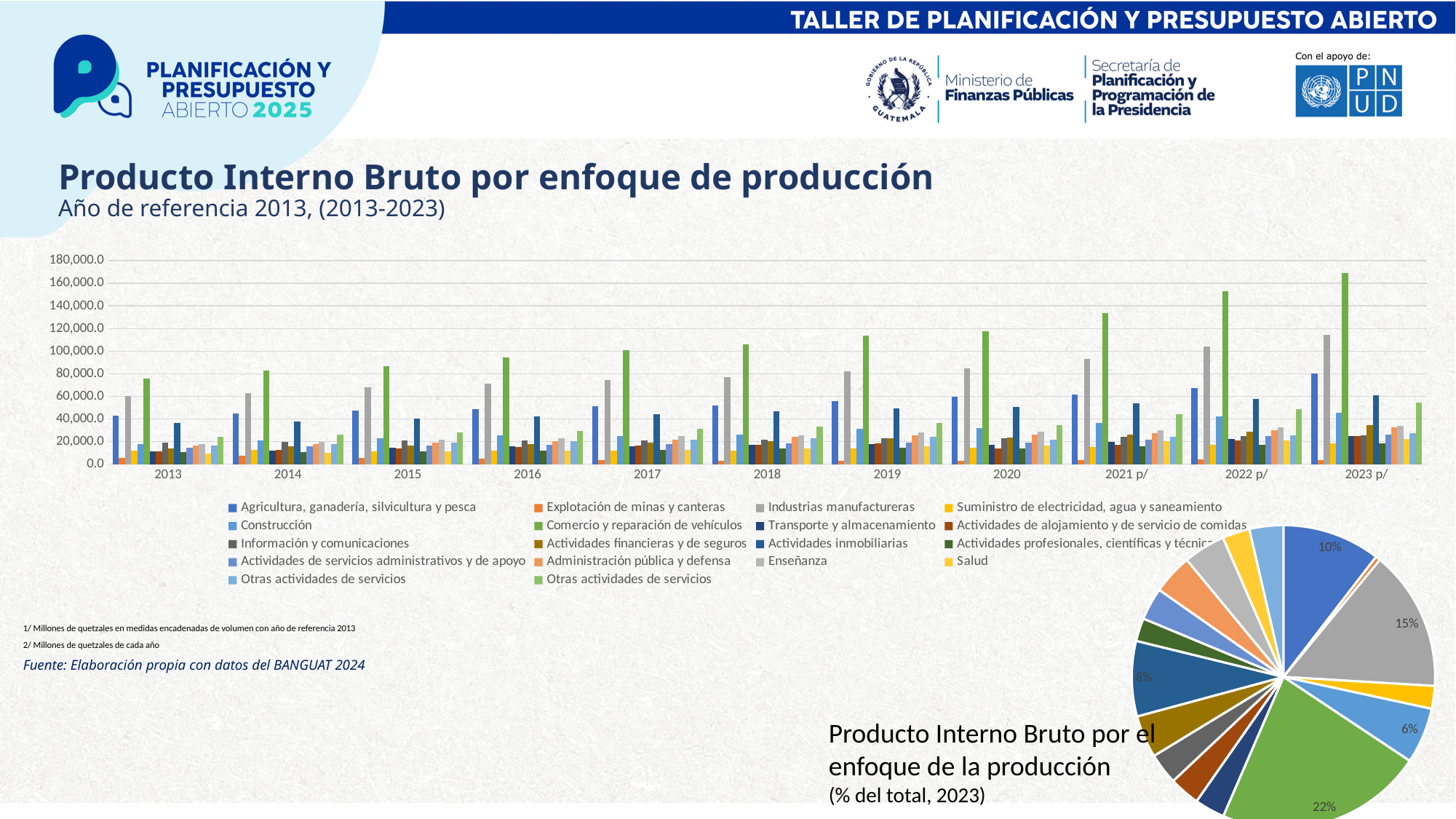
In the pie chart 'Producto Interno Bruto por el enfoque de la producción (% del total, 2023)', what is the largest percentage labelled on a slice? 22% What kind of chart is the large chart at the top of the slide, titled 'Producto Interno Bruto por enfoque de producción'? Bar chart In the bar chart 'Producto Interno Bruto por enfoque de producción', which is larger in 2023 p/: Agricultura, ganadería, silvicultura y pesca or Industrias manufactureras? Industrias manufactureras In the pie chart 'Producto Interno Bruto por el enfoque de la producción (% del total, 2023)', what is the difference between the 22% slice and the 15% slice? 7% How many series does the legend of the bar chart 'Producto Interno Bruto por enfoque de producción' list? 18 In the bar chart 'Producto Interno Bruto por enfoque de producción', is the value for Comercio y reparación de vehículos in 2023 p/ greater or less than 160,000.0? greater In the bar chart 'Producto Interno Bruto por enfoque de producción', is the value for Industrias manufactureras in 2023 p/ greater or less than 100,000.0? greater In the bar chart 'Producto Interno Bruto por enfoque de producción', is the value for Comercio y reparación de vehículos in 2013 greater or less than 80,000.0? less According to the source note on the slide, whose data was used to build the charts? BANGUAT 2024 In the bar chart 'Producto Interno Bruto por enfoque de producción', does the value for Comercio y reparación de vehículos rise or fall from 2013 to 2023 p/? Rises In the bar chart 'Producto Interno Bruto por enfoque de producción', how many years are shown along the x axis? 11 In the bar chart 'Producto Interno Bruto por enfoque de producción', which series has the highest bar in 2023 p/? Comercio y reparación de vehículos